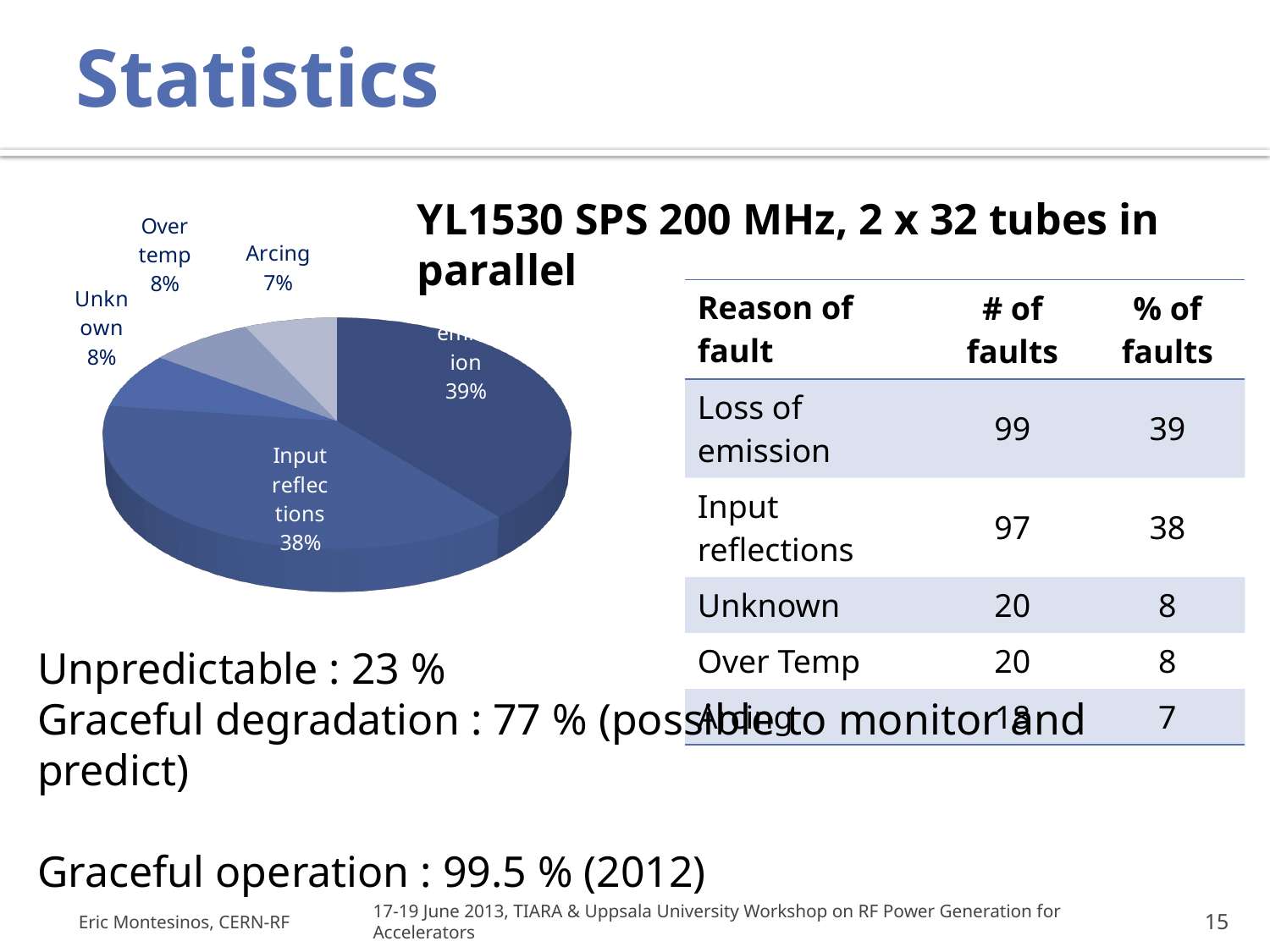
What share of the pie chart does Arcing represent? 7% What is the title shown above the pie chart? YL1530 SPS 200 MHz, 2 x 32 tubes in parallel What share of the pie chart does Unknown represent? 8% Which category has the largest slice in the pie chart? Loss of emission Which slice is larger in the pie chart, Input reflections or Arcing? Input reflections Which category has the smallest slice in the pie chart? Arcing What share of the pie chart does Input reflections represent? 38% What is the difference in percentage points between the Input reflections slice and the Arcing slice? 31 What kind of chart is shown on the slide? pie chart What is the difference in percentage points between the Unknown slice and the Arcing slice? 1 How many slices does the pie chart have? 5